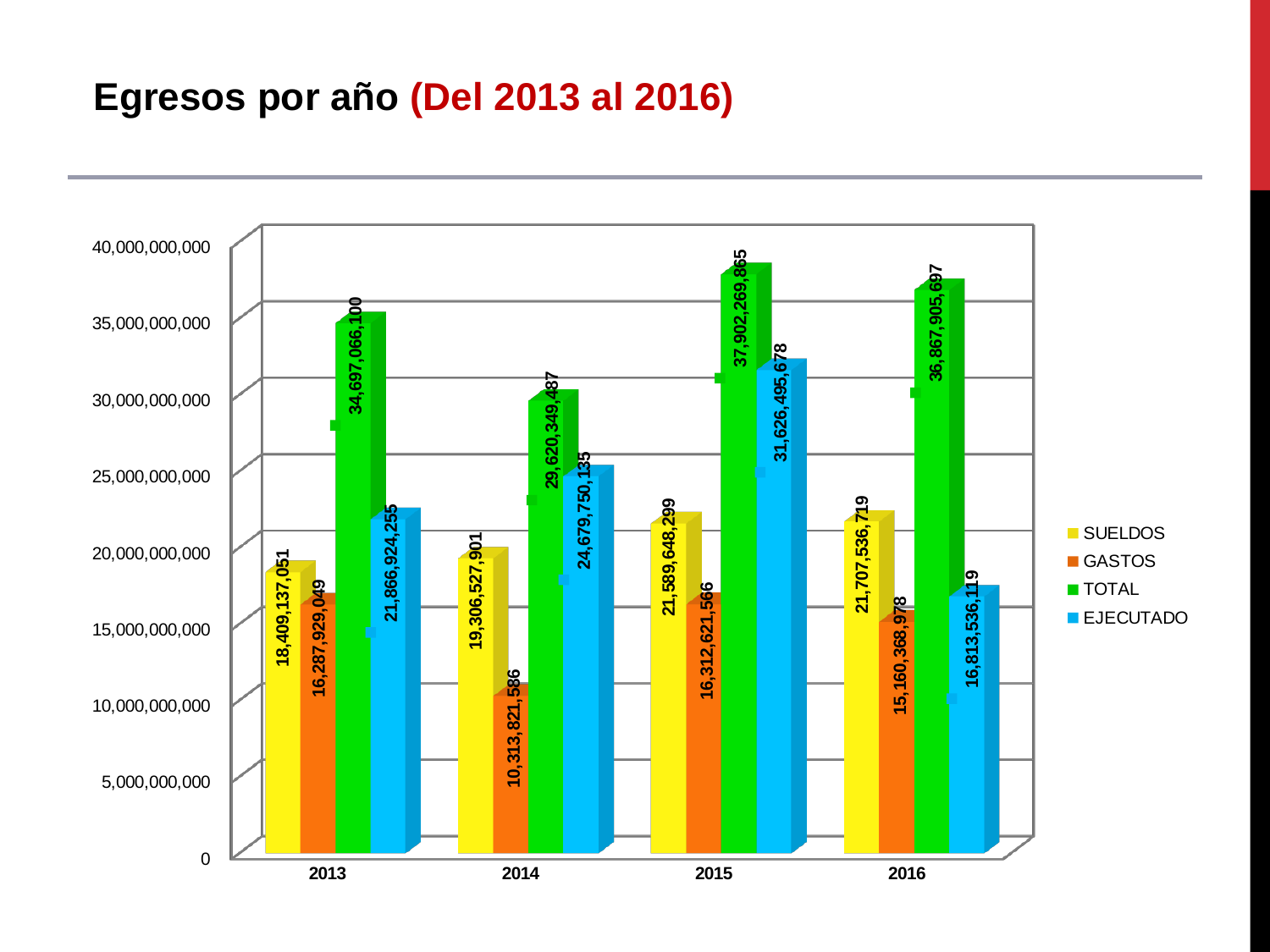
What type of chart is shown on the slide? Bar chart How many series does the legend list? 4 What is the SUELDOS value for 2013? 18,409,137,051 What is the TOTAL value for 2015? 37,902,269,865 Which is larger, the EJECUTADO value for 2014 or for 2016? 2014 In which year is the TOTAL value highest? 2015 Which series is shown in green in the legend? TOTAL How many years are shown on the x axis? 4 In which year is the GASTOS value lowest? 2014 What is the GASTOS value for 2014? 10,313,821,586 What is the difference between the TOTAL values for 2015 and 2014? 8,281,920,378 What is the EJECUTADO value for 2016? 16,813,536,119